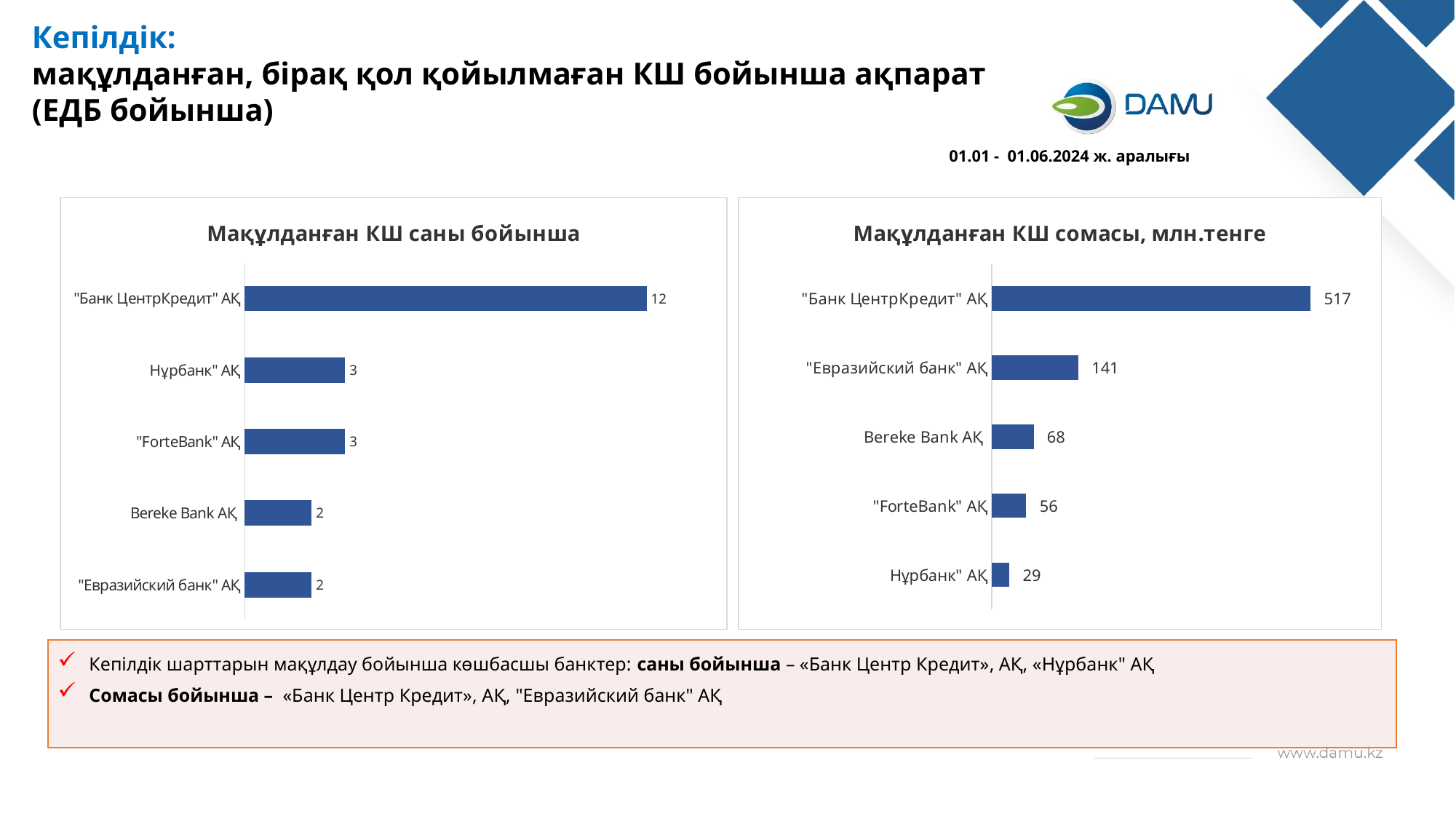
In the chart titled "Мақұлданған КШ саны бойынша", what is the difference between "Банк ЦентрКредит" АҚ and Нұрбанк" АҚ? 9 What kind of chart is the chart titled "Мақұлданған КШ сомасы, млн.тенге"? Bar chart In the chart titled "Мақұлданған КШ саны бойынша", what is the total of the values for Bereke Bank АҚ and "Евразийский банк" АҚ? 4 In the chart titled "Мақұлданған КШ сомасы, млн.тенге", which bank has the lowest value? Нұрбанк" АҚ In the chart titled "Мақұлданған КШ сомасы, млн.тенге", what is the value for "Евразийский банк" АҚ? 141 In the chart titled "Мақұлданған КШ сомасы, млн.тенге", what is the difference between "Банк ЦентрКредит" АҚ and "Евразийский банк" АҚ? 376 In the chart titled "Мақұлданған КШ саны бойынша", what is the value for "Банк ЦентрКредит" АҚ? 12 In the chart titled "Мақұлданған КШ саны бойынша", which bank has the highest value? "Банк ЦентрКредит" АҚ What is the title of the chart on the right side of the slide? Мақұлданған КШ сомасы, млн.тенге How many banks are shown in the chart titled "Мақұлданған КШ саны бойынша"? 5 In the chart titled "Мақұлданған КШ сомасы, млн.тенге", which is larger: Bereke Bank АҚ or "ForteBank" АҚ? Bereke Bank АҚ In the chart titled "Мақұлданған КШ сомасы, млн.тенге", what is the value for Нұрбанк" АҚ? 29